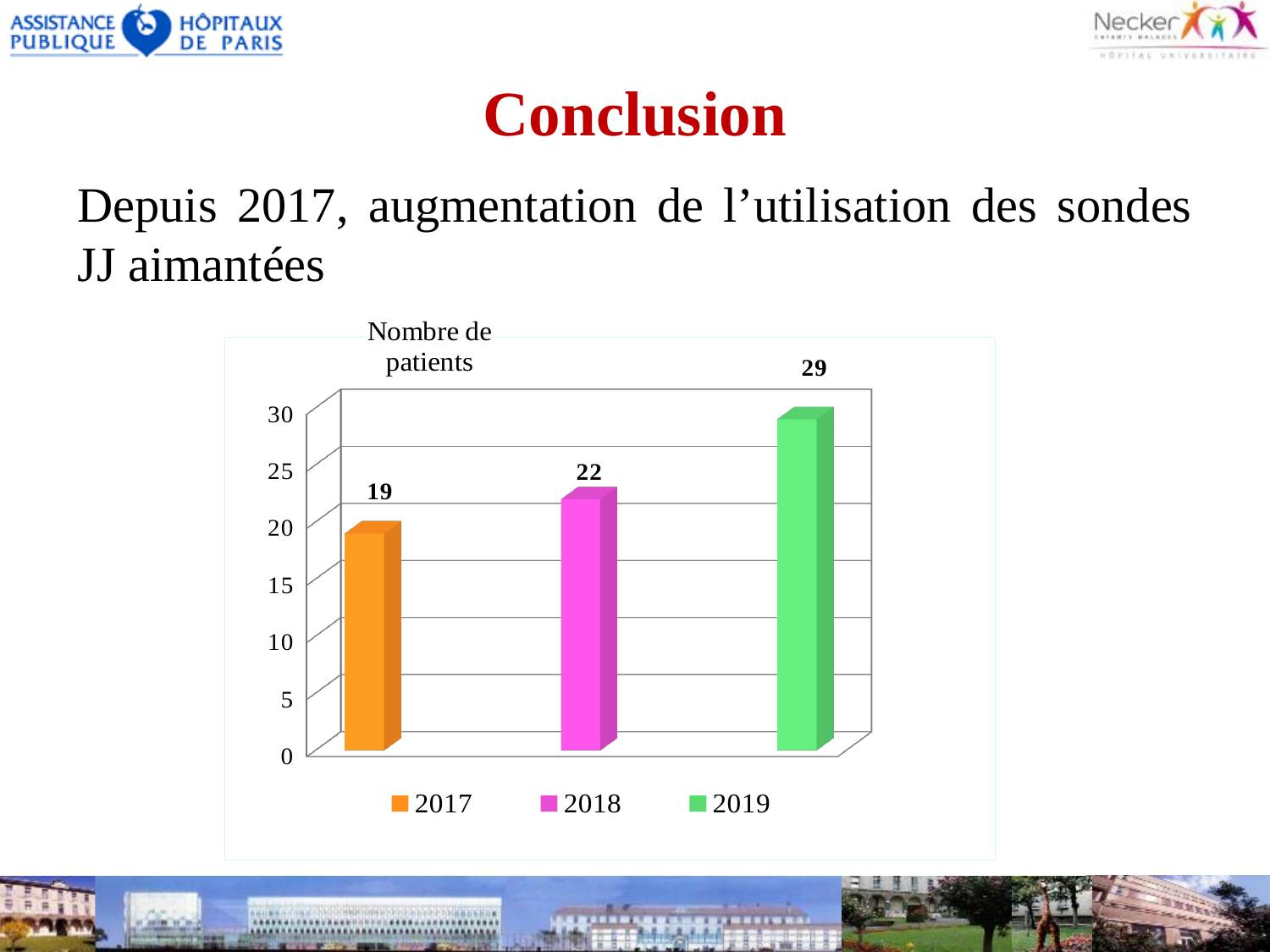
Is the value for 2019 greater or less than 25? greater How many years are shown in the chart? 3 Do the values rise or fall from 2017 to 2019? rise What is the number of patients for 2017? 19 What is the difference in number of patients between 2018 and 2017? 3 What is the number of patients for 2018? 22 What is the difference in number of patients between 2019 and 2017? 10 What is the number of patients for 2019? 29 Which year has more patients, 2018 or 2019? 2019 What kind of chart is shown on the slide? bar chart Which year has the lowest number of patients? 2017 Which year has the highest number of patients? 2019